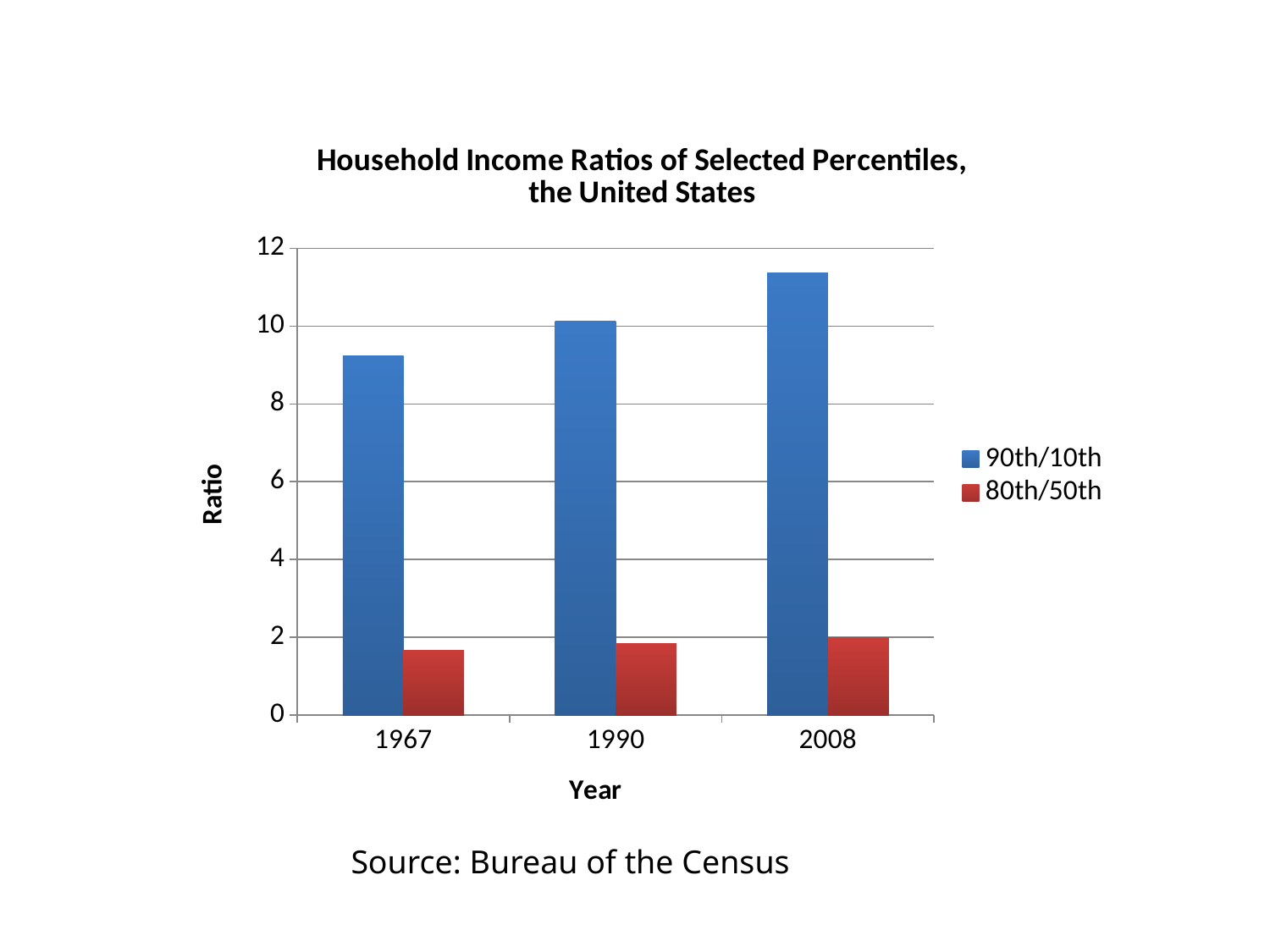
In which year is the 90th/10th ratio lowest? 1967 Is the 90th/10th ratio for 1967 greater or less than 10? less In which year is the 80th/50th ratio lowest? 1967 How many series does the legend list? 2 What kind of chart is shown on the slide? bar chart Is the 90th/10th ratio for 1967 greater or less than 8? greater Does the 90th/10th ratio rise or fall from 1967 to 2008? rise Is the 90th/10th ratio for 2008 greater or less than 10? greater How many years are shown on the x axis? 3 Which is larger in 1990, the 90th/10th ratio or the 80th/50th ratio? 90th/10th In which year is the 90th/10th ratio highest? 2008